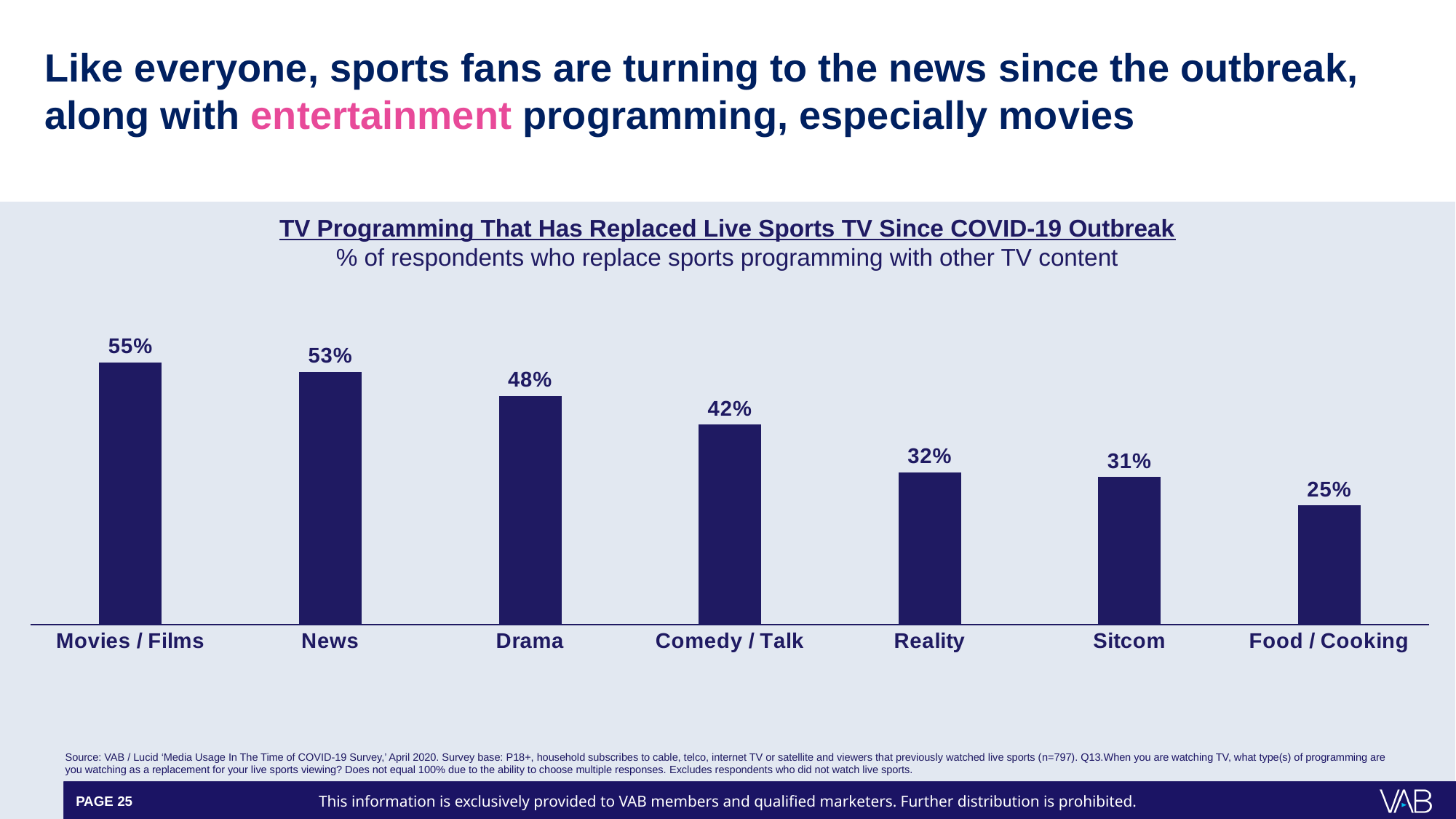
What percentage is shown for Comedy / Talk? 42% Which programming category has the highest percentage? Movies / Films Which programming category has the lowest percentage? Food / Cooking Do the values rise or fall from left to right across the categories? Fall What is the difference in percentage points between Movies / Films and News? 2 What is the value for Food / Cooking? 25% Which has a higher value, Comedy / Talk or Sitcom? Comedy / Talk What percentage of respondents replaced live sports with Movies / Films? 55% How many programming categories are shown in the chart? 7 What kind of chart is shown on the slide? Bar chart What is the difference in percentage points between Drama and Reality? 16 What is the value shown for News? 53%